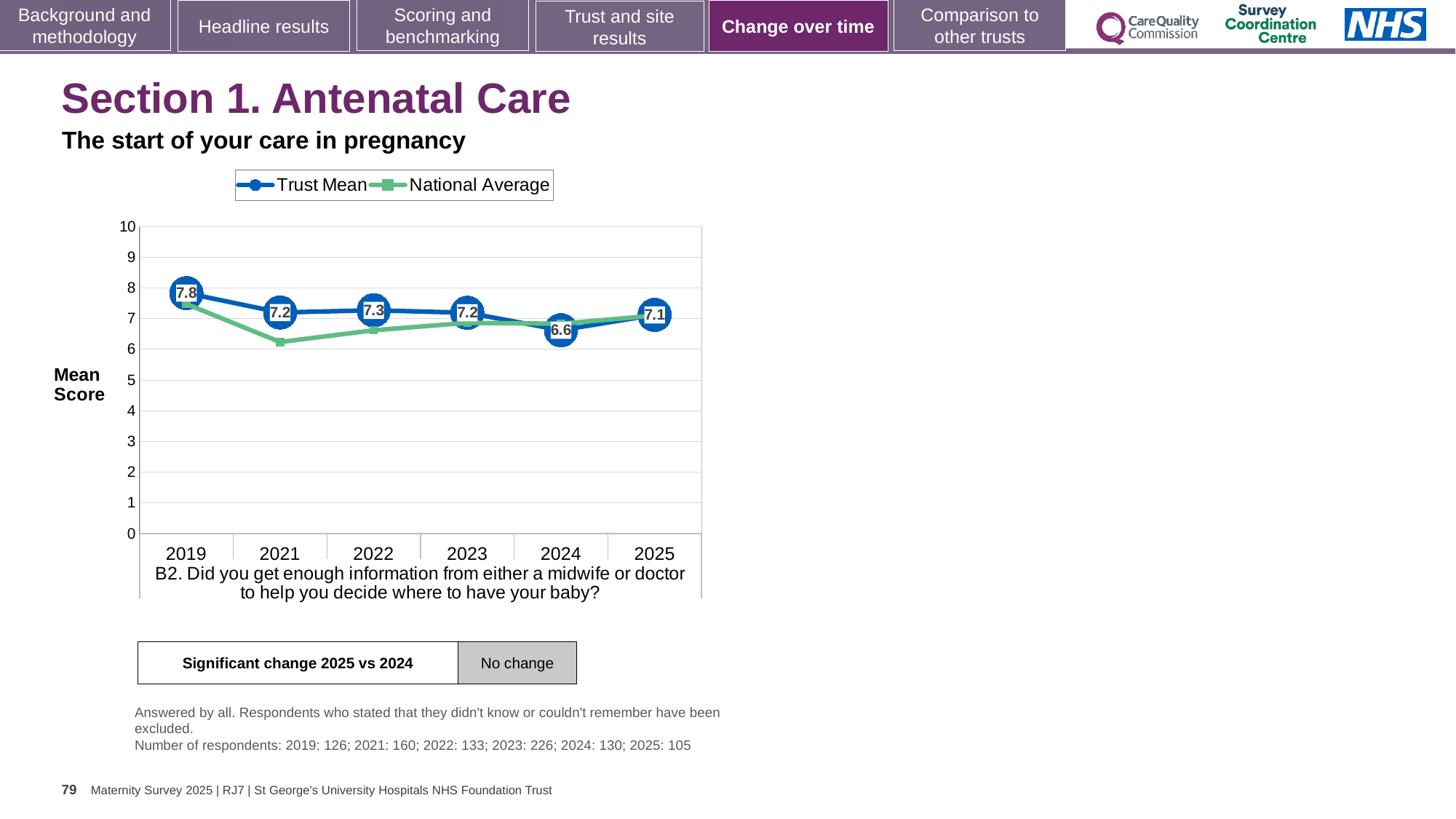
What is the Trust Mean score for 2019? 7.8 Does the Trust Mean rise or fall from 2024 to 2025? rise In which year is the Trust Mean lowest? 2024 How many years are plotted on the x axis? 6 In which year is the Trust Mean highest? 2019 What kind of chart is shown? line chart What is the Trust Mean score for 2025? 7.1 How many series does the legend list? 2 Is the National Average value for 2021 greater or less than 7? less What is the difference between the Trust Mean in 2019 and in 2024? 1.2 What is the Trust Mean score for 2024? 6.6 Which year has the larger Trust Mean, 2022 or 2024? 2022